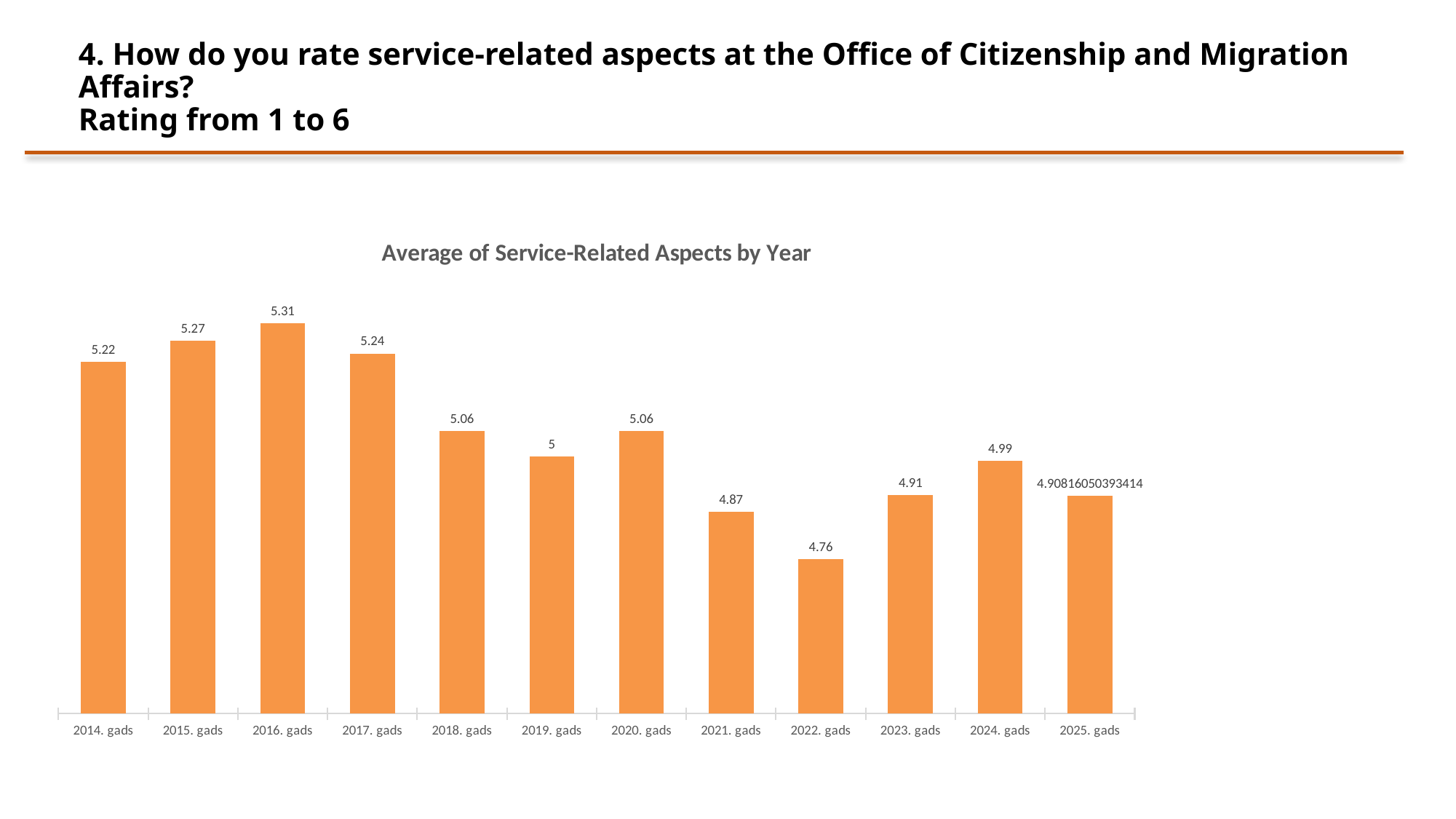
Do the average ratings generally rise or fall from 2016. gads to 2022. gads? Fall What is the difference between the average ratings for 2014. gads and 2015. gads? 0.05 What is the average rating for 2016. gads? 5.31 What is the title of the chart? Average of Service-Related Aspects by Year What kind of chart is shown on the slide? Bar chart Which is larger, the average rating for 2017. gads or for 2021. gads? 2017. gads How many years are shown on the chart? 12 Which year has the highest average rating? 2016. gads What is the average rating for 2022. gads? 4.76 Which year has the lowest average rating? 2022. gads What value is labelled on the bar for 2025. gads? 4.90816050393414 What is the difference between the average ratings for 2016. gads and 2022. gads? 0.55